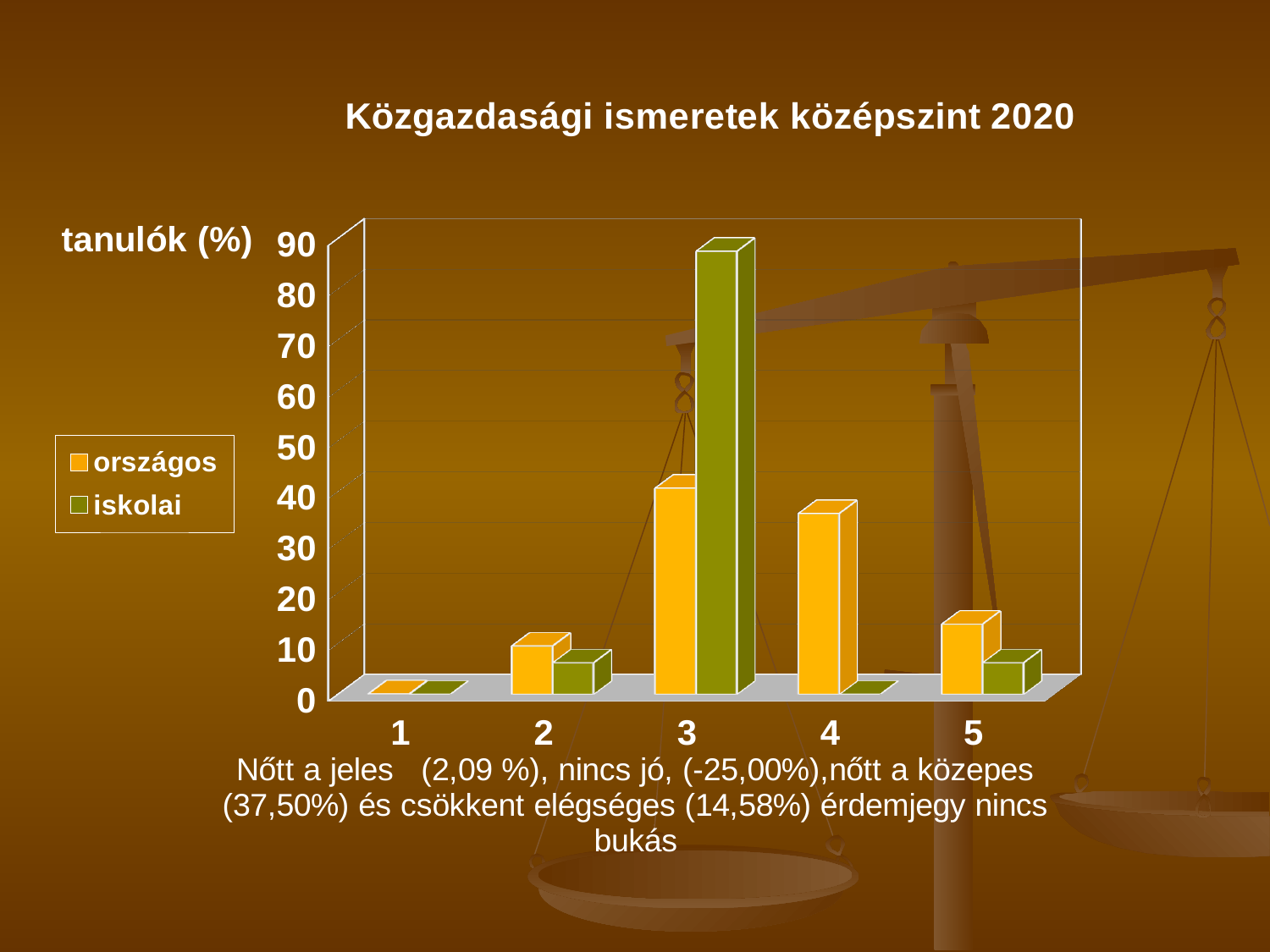
Which category has the highest value for the országos series? 3 What is the title of the chart? Közgazdasági ismeretek középszint 2020 For category 4, which series has the larger value, országos or iskolai? országos Is the iskolai value for category 3 greater or less than 80? greater What kind of chart is shown on the slide? bar chart Which category has the lowest value for the országos series? 1 Which category has the highest value for the iskolai series? 3 For category 3, which series has the larger value, országos or iskolai? iskolai How many series does the legend list? 2 How many categories are shown on the x axis? 5 Is the országos value for category 4 greater or less than 50? less Is the országos value for category 3 greater or less than 30? greater